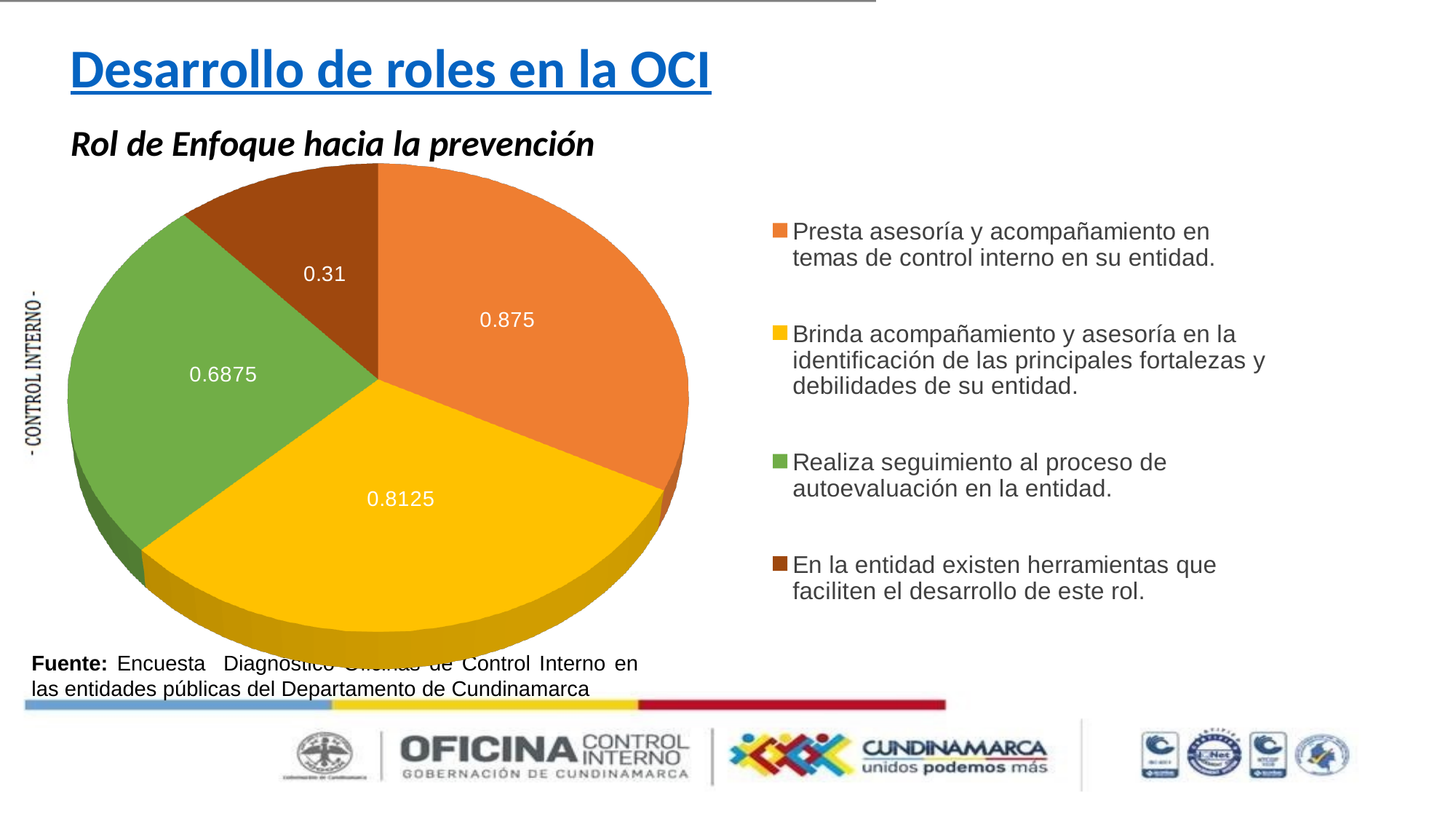
Which legend category has the highest value in the pie chart? Presta asesoría y acompañamiento en temas de control interno en su entidad. What value is shown for the slice 'Presta asesoría y acompañamiento en temas de control interno en su entidad.'? 0.875 What is the difference between the value for 'Brinda acompañamiento y asesoría en la identificación de las principales fortalezas y debilidades de su entidad.' and the value for 'Realiza seguimiento al proceso de autoevaluación en la entidad.'? 0.125 What value is shown for the slice 'En la entidad existen herramientas que faciliten el desarrollo de este rol.'? 0.31 Which is larger: the value for 'Realiza seguimiento al proceso de autoevaluación en la entidad.' or the value for 'En la entidad existen herramientas que faciliten el desarrollo de este rol.'? Realiza seguimiento al proceso de autoevaluación en la entidad. What is the difference between the value for 'Presta asesoría y acompañamiento en temas de control interno en su entidad.' and the value for 'En la entidad existen herramientas que faciliten el desarrollo de este rol.'? 0.565 What kind of chart is shown on the slide? Pie chart What colour is the slice for 'Realiza seguimiento al proceso de autoevaluación en la entidad.'? Green How many slices does the pie chart have? 4 What value is shown for the slice 'Brinda acompañamiento y asesoría en la identificación de las principales fortalezas y debilidades de su entidad.'? 0.8125 Which legend category has the lowest value in the pie chart? En la entidad existen herramientas que faciliten el desarrollo de este rol. What value is shown for the slice 'Realiza seguimiento al proceso de autoevaluación en la entidad.'? 0.6875